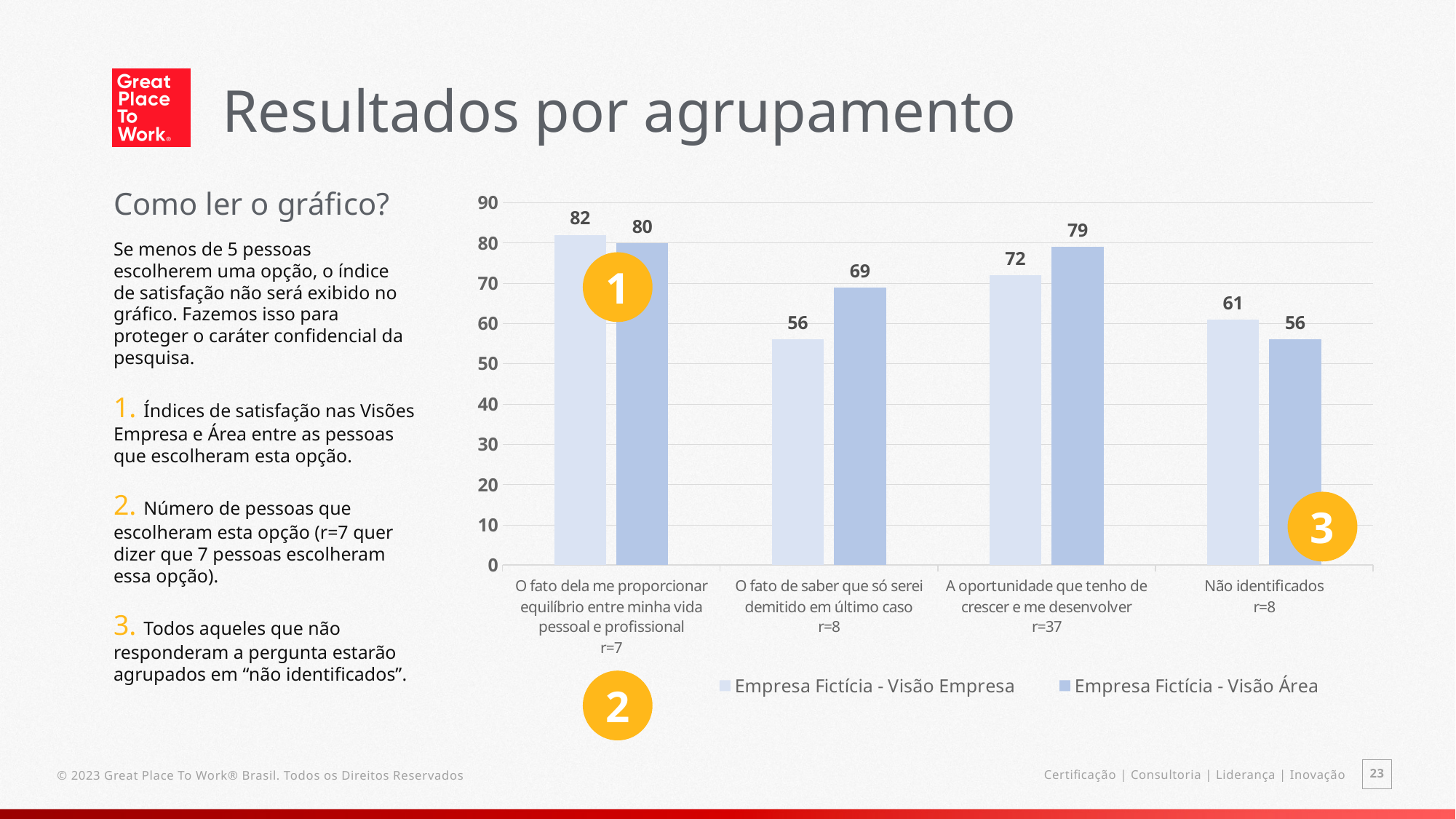
What is the value for 'Empresa Fictícia - Visão Área' in the category 'O fato de saber que só serei demitido em último caso'? 69 What is the value for 'Empresa Fictícia - Visão Empresa' in the category 'O fato dela me proporcionar equilíbrio entre minha vida pessoal e profissional'? 82 Which category has the highest value for 'Empresa Fictícia - Visão Empresa'? O fato dela me proporcionar equilíbrio entre minha vida pessoal e profissional What is the number of respondents (r) shown for the category 'A oportunidade que tenho de crescer e me desenvolver'? r=37 What kind of chart is shown on the slide? Bar chart Which category has the lowest value for 'Empresa Fictícia - Visão Área'? Não identificados How many series does the legend list? 2 What is the value for 'Empresa Fictícia - Visão Área' in the category 'Não identificados'? 56 In the category 'A oportunidade que tenho de crescer e me desenvolver', which series has the larger value? Empresa Fictícia - Visão Área What is the difference between the 'Visão Empresa' and 'Visão Área' values in the category 'Não identificados'? 5 What is the difference between the 'Visão Área' and 'Visão Empresa' values in the category 'O fato de saber que só serei demitido em último caso'? 13 How many categories are shown on the x axis of the chart? 4